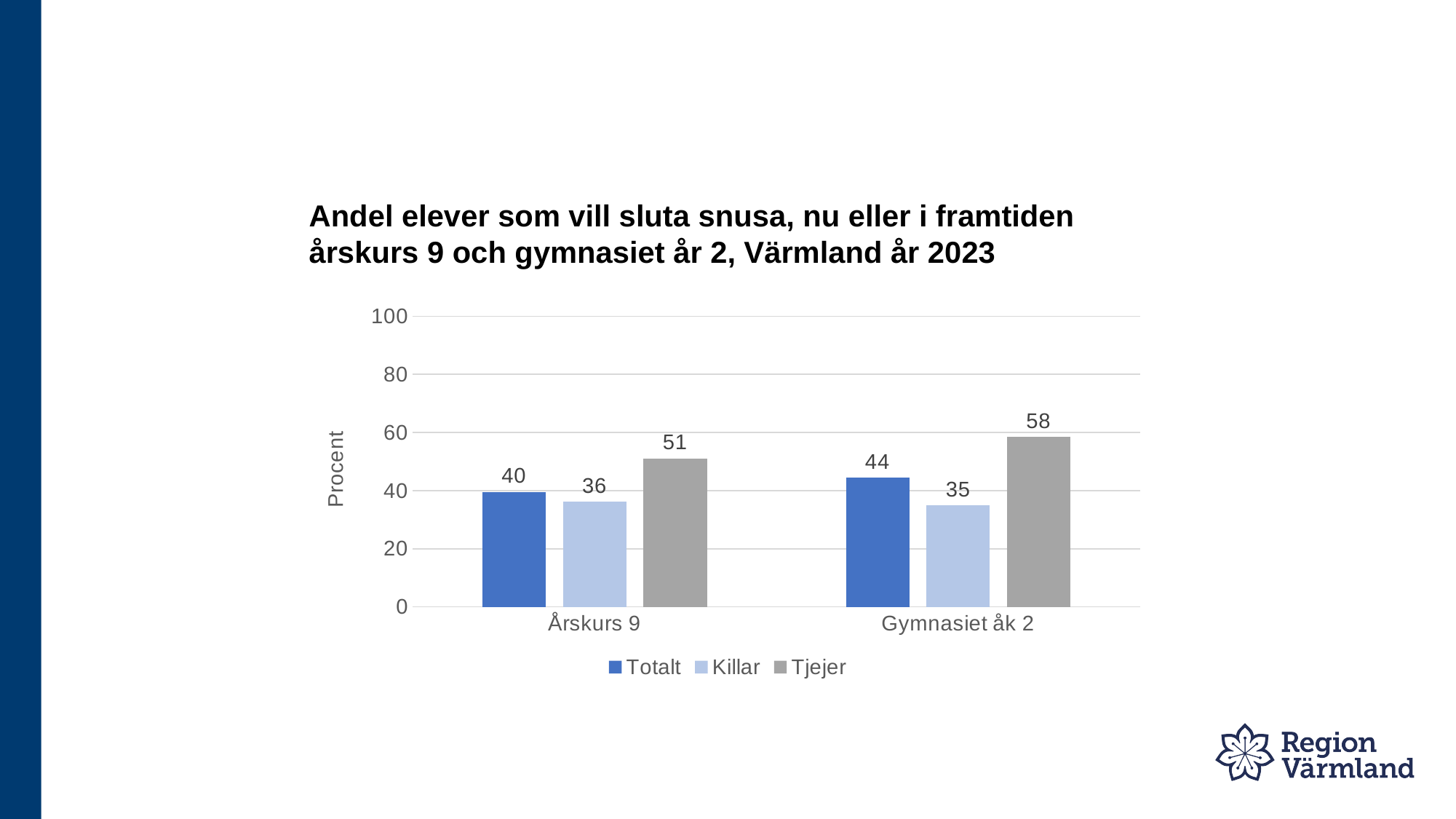
What is the value for Tjejer in Årskurs 9? 51 What is the difference between the Totalt values for Gymnasiet åk 2 and Årskurs 9? 4 Is the value for Tjejer in Årskurs 9 greater or less than 60? less Which series has the highest value in Gymnasiet åk 2? Tjejer What is the label of the vertical axis? Procent How many series does the legend list? 3 What is the difference between Tjejer and Killar in Gymnasiet åk 2? 23 Which series has the lowest value in Årskurs 9? Killar What kind of chart is shown on the slide? Bar chart Which is larger: Killar in Årskurs 9 or Killar in Gymnasiet åk 2? Killar in Årskurs 9 What is the value for Killar in Gymnasiet åk 2? 35 What is the value for Totalt in Gymnasiet åk 2? 44